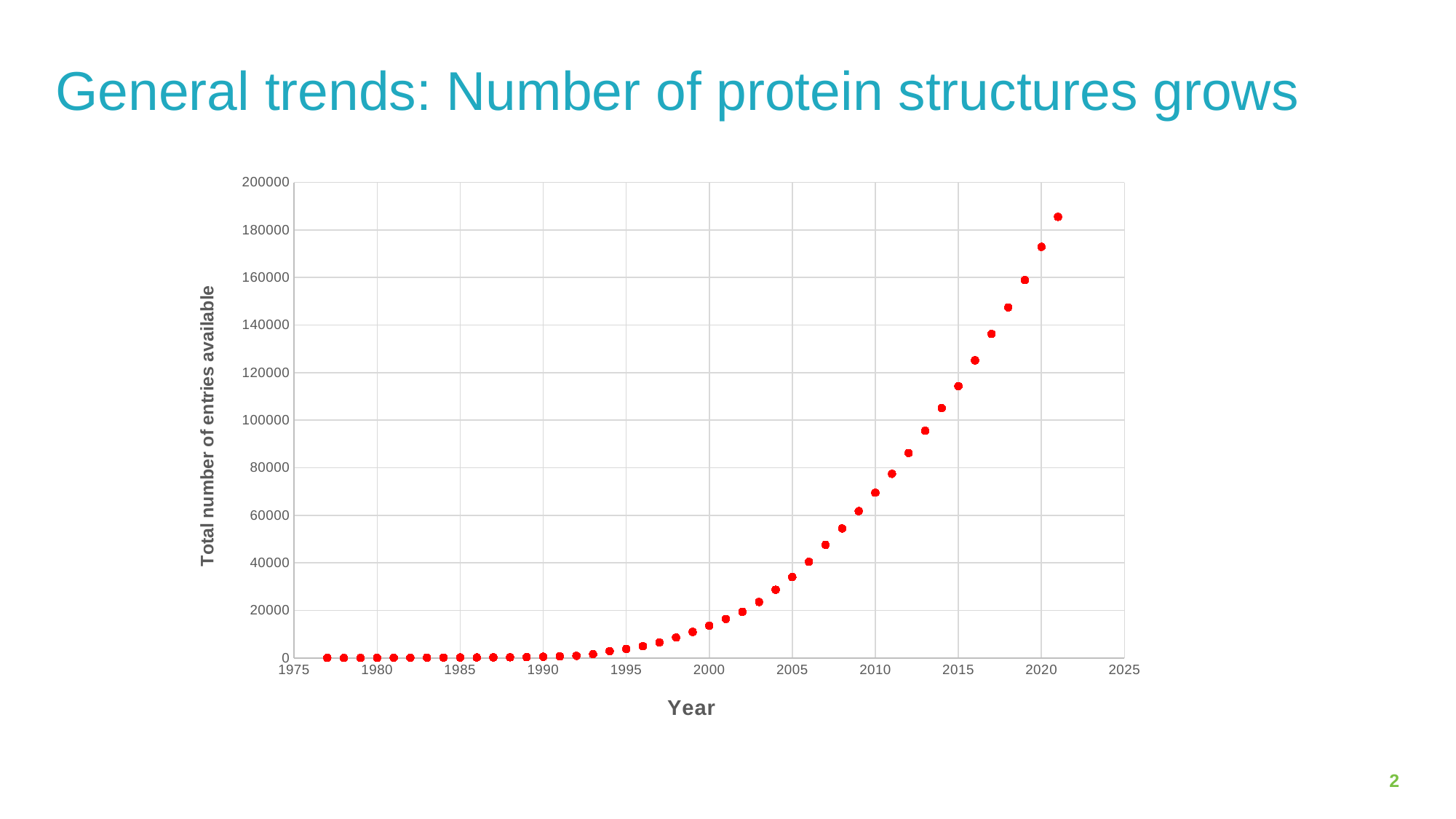
Is the value for 2020 greater or less than 160000? greater What is the label of the y axis? Total number of entries available Is the value for 2000 greater or less than 20000? less Is the value for 2021 greater or less than 200000? less What kind of chart is shown on the slide? scatter plot Which year has the larger value, 2010 or 2015? 2015 Do the values rise or fall as the year increases along the x axis? rise What is the title of the slide containing the chart? General trends: Number of protein structures grows Which year has the highest total number of entries available? 2021